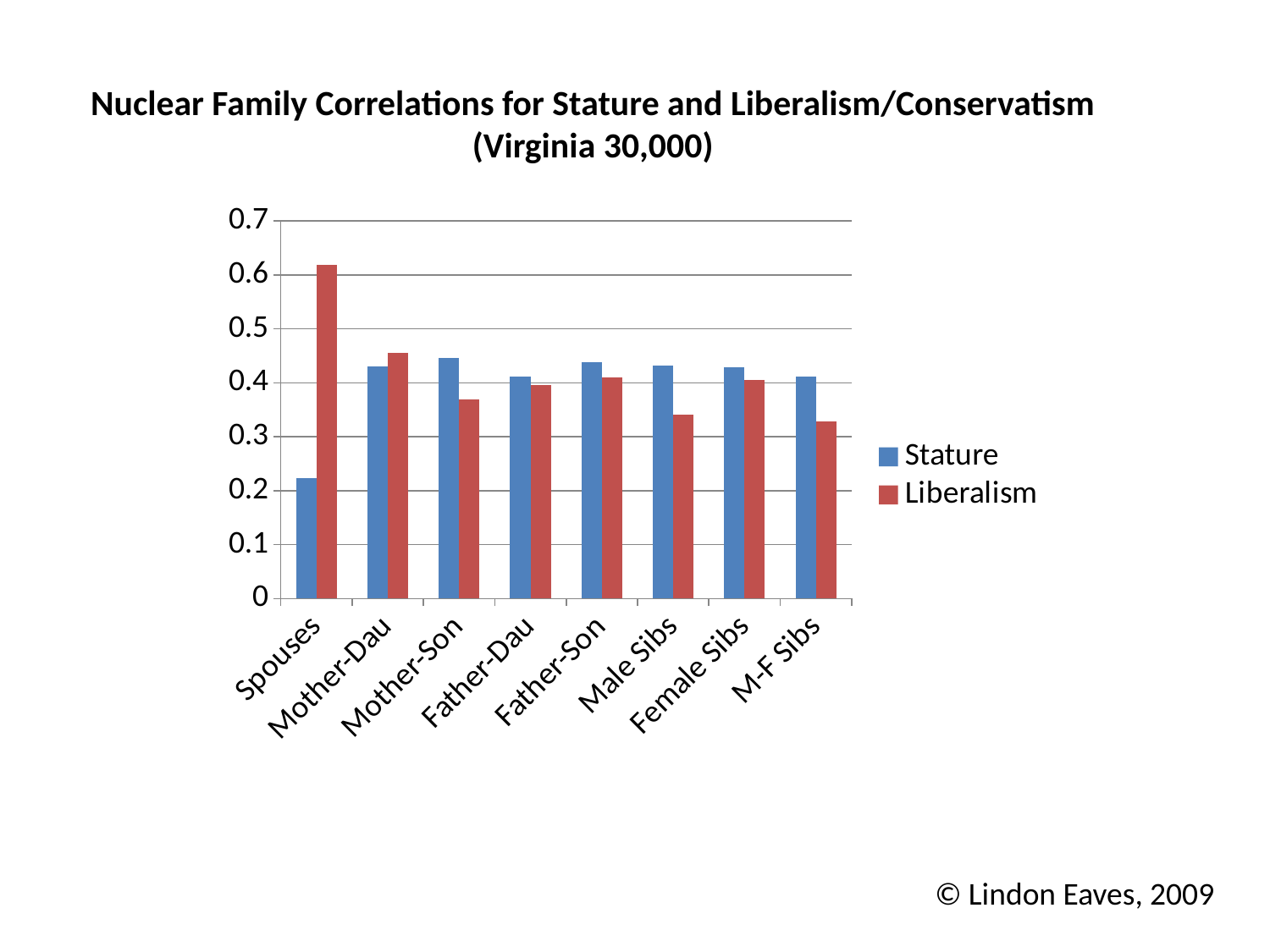
How many series does the legend list? 2 Which colour represents the Liberalism series in the legend? Red Is the Stature value for Spouses greater or less than 0.3? less What kind of chart is shown on the slide? Bar chart For Male Sibs, which is larger, the Stature or the Liberalism correlation? Stature Which category has the lowest Stature correlation? Spouses How many family-pair categories are shown on the x axis? 8 Is the Liberalism value for Spouses greater or less than 0.6? greater Which category has the highest Liberalism correlation? Spouses For Mother-Son, which is larger, the Stature or the Liberalism correlation? Stature For Spouses, which is larger, the Stature or the Liberalism correlation? Liberalism Is the Liberalism value for Male Sibs greater or less than 0.4? less